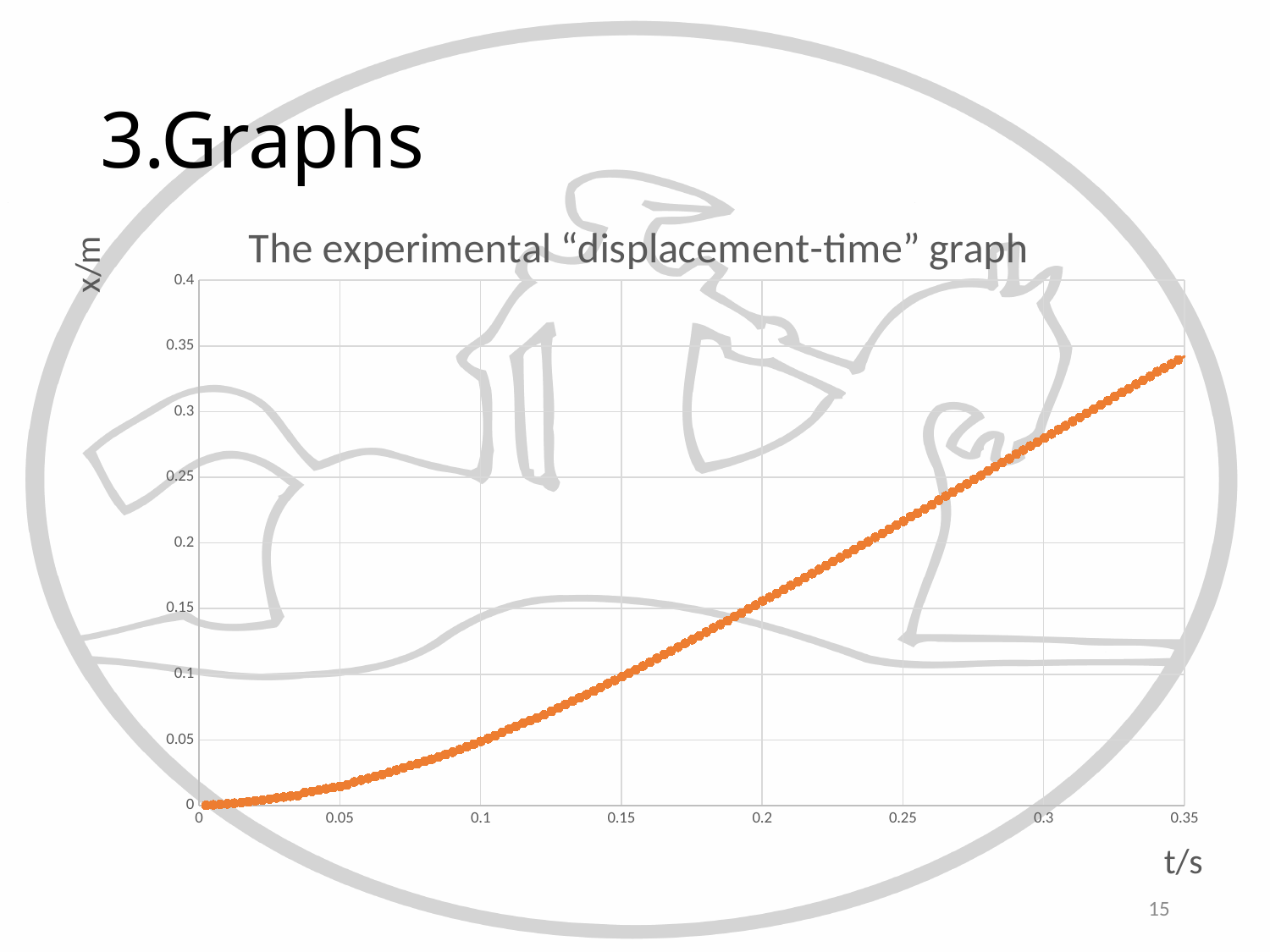
What is the highest tick value shown on the vertical axis? 0.4 Is the displacement value at t = 0.3 s greater or less than 0.25? greater At which time value on the x axis is the plotted displacement highest? 0.35 Is the displacement value at t = 0.35 s greater or less than 0.35? less Is the displacement value at t = 0.35 s greater or less than 0.3? greater What is the label of the vertical axis of the chart? x/m Do the plotted displacement values rise or fall as time increases along the x axis? rise What kind of chart is shown on the slide? scatter chart What is the title of the chart? The experimental "displacement-time" graph Which has the larger displacement value, t = 0.1 s or t = 0.3 s? t = 0.3 s